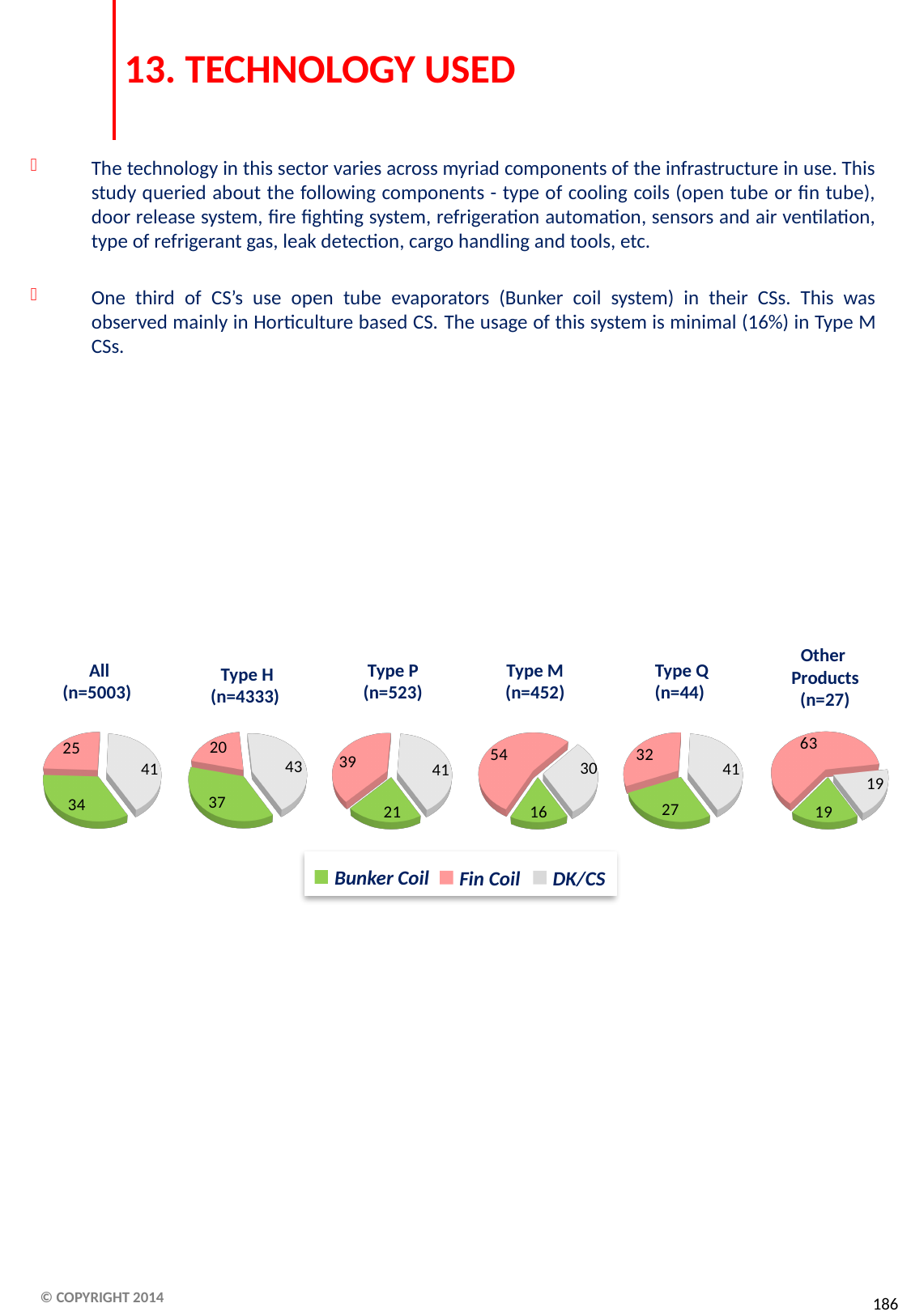
In the 'Other Products (n=27)' pie chart, which slice is the largest? Fin Coil In the 'Type P (n=523)' pie chart, what is the difference between the Fin Coil value and the Bunker Coil value? 18 In the 'Type Q (n=44)' pie chart, which is larger, Fin Coil or Bunker Coil? Fin Coil In the 'Type H (n=4333)' pie chart, what is the value for Fin Coil? 20 How many series does the legend list for the pie charts? 3 Which colour represents Bunker Coil in the pie charts? Green In the 'All (n=5003)' pie chart, what is the value for Bunker Coil? 34 In the 'Type M (n=452)' pie chart, what is the value for Fin Coil? 54 What kind of chart is used to show the technology used for each CS type? Pie chart In the 'Type M (n=452)' pie chart, which slice is the smallest? Bunker Coil How many pie charts are shown on the slide? 6 In the 'Type H (n=4333)' pie chart, what is the value for DK/CS? 43